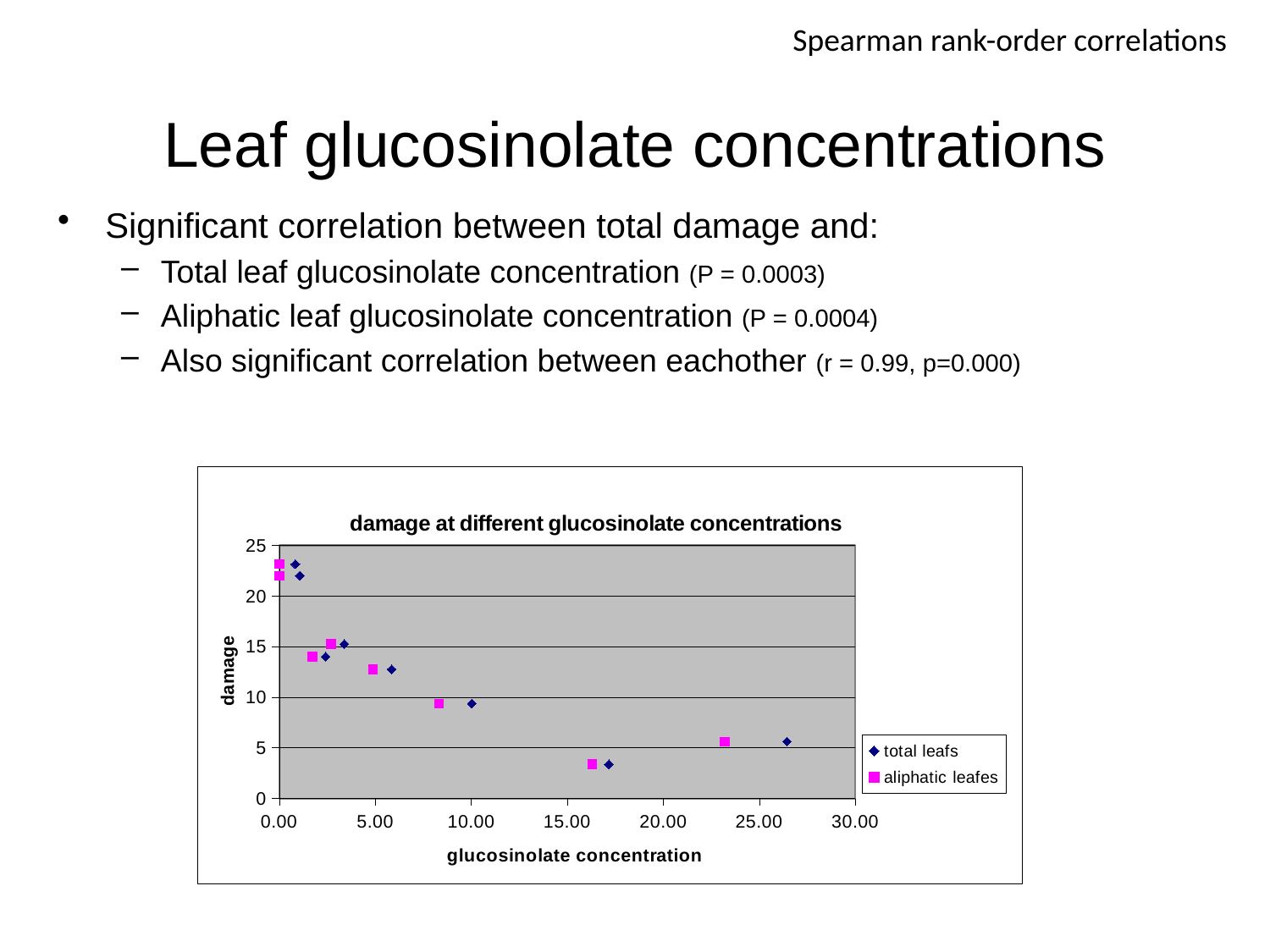
What are the two series named in the chart legend? total leafs and aliphatic leafes Is the lowest damage value for the aliphatic leafes series greater or less than 5? less What is the maximum value shown on the x axis of the chart? 30.00 Is the damage for the total leafs point with the highest glucosinolate concentration greater or less than 10? less What kind of chart is shown on the slide? scatter plot Is the damage for the aliphatic leafes point at a glucosinolate concentration of about 8 greater or less than 5? greater How many series does the chart legend list? 2 What is the title of the chart? damage at different glucosinolate concentrations Which series has the point with the highest glucosinolate concentration, total leafs or aliphatic leafes? total leafs As glucosinolate concentration increases along the x axis, does damage generally rise or fall? fall